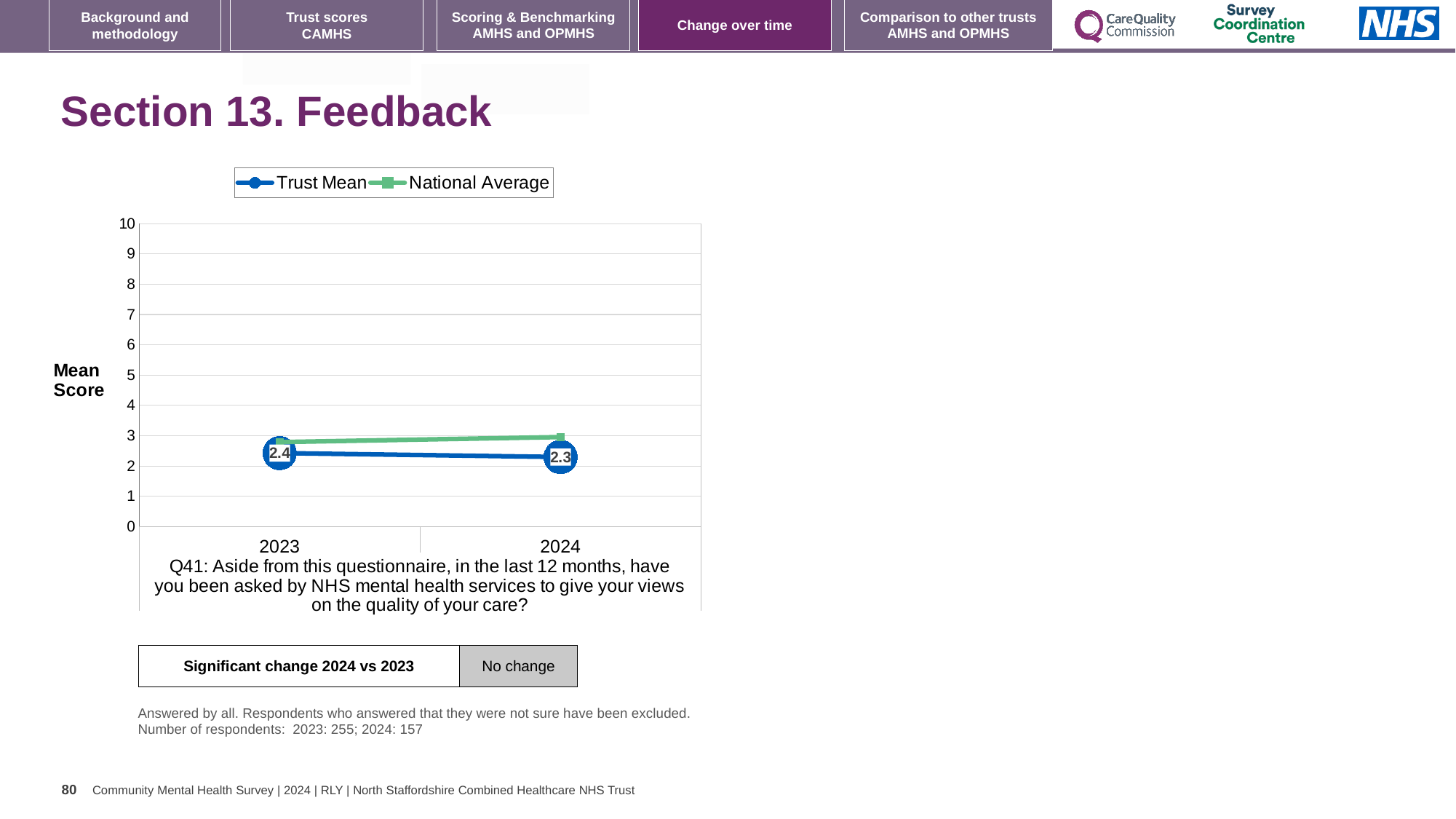
What is the title of the chart's y axis? Mean Score How many series does the chart legend list? 2 Which year has the higher Trust Mean, 2023 or 2024? 2023 In 2024, which is higher: the Trust Mean or the National Average? National Average What is the Trust Mean value for 2024? 2.3 Does the Trust Mean rise or fall from 2023 to 2024? fall What is the difference between the Trust Mean in 2023 and in 2024? 0.1 What kind of chart is shown on the slide? line chart What is the Trust Mean value for 2023? 2.4 Is the National Average value for 2024 greater or less than 2? greater How many years are shown on the x axis of the chart? 2 Is the National Average value for 2023 greater or less than 5? less